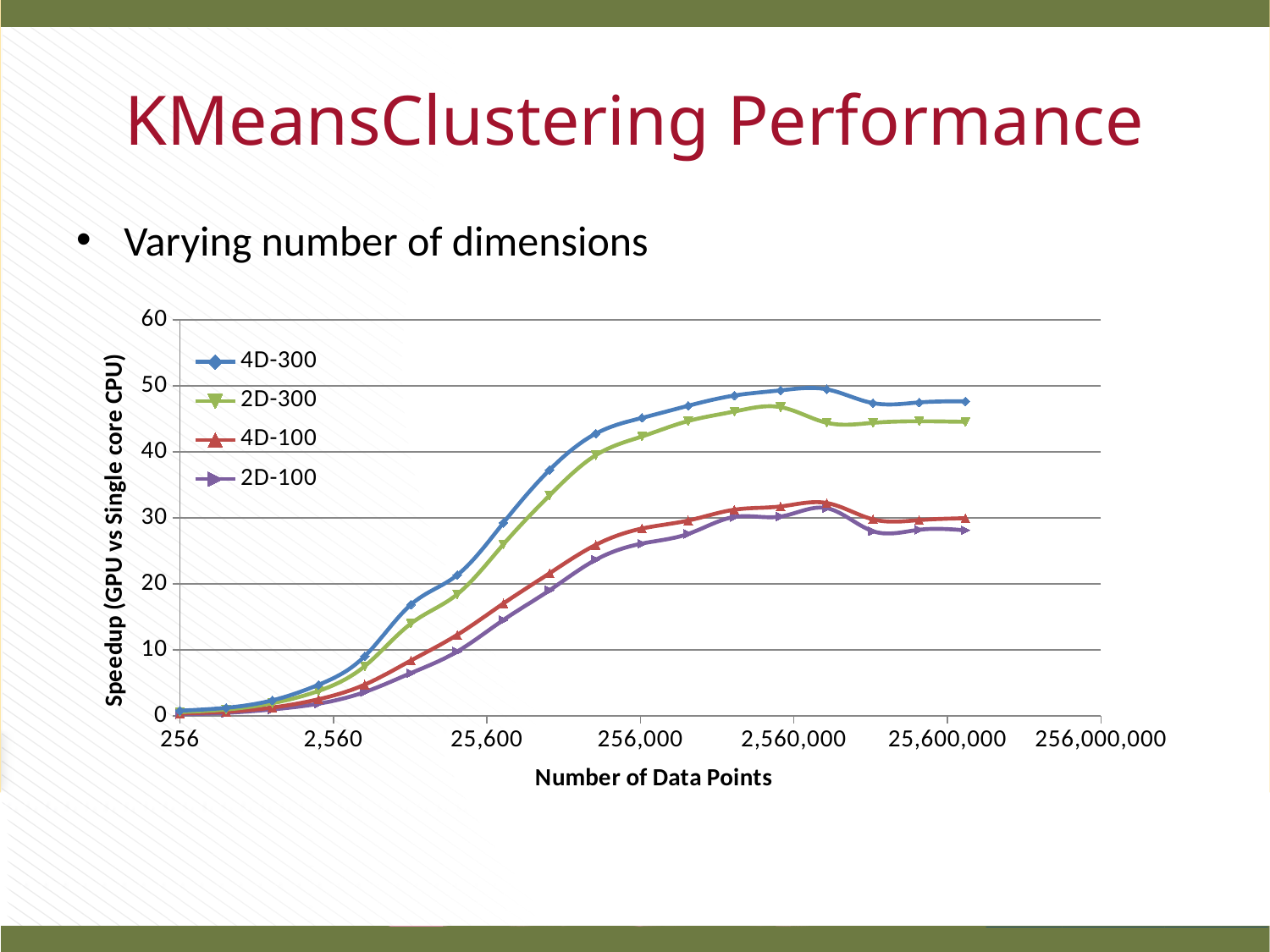
At 256,000 data points, which series has the higher speedup, 4D-300 or 2D-100? 4D-300 Is the speedup for 2D-100 at 25,600 data points greater or less than 20? less Is the speedup for 4D-300 at 2,560,000 data points greater or less than 40? greater What are the series names listed in the chart's legend? 4D-300, 2D-300, 4D-100, 2D-100 Which series reaches the highest speedup on the chart? 4D-300 What is the title of the chart's vertical axis? Speedup (GPU vs Single core CPU) At 2,560,000 data points, which series has the higher speedup, 4D-100 or 2D-300? 2D-300 What kind of chart is shown on the slide? line chart Does the speedup for 4D-300 rise or fall as the number of data points increases from 256 to 256,000? rise Is the speedup for 2D-300 at 256 data points greater or less than 10? less How many series does the chart's legend list? 4